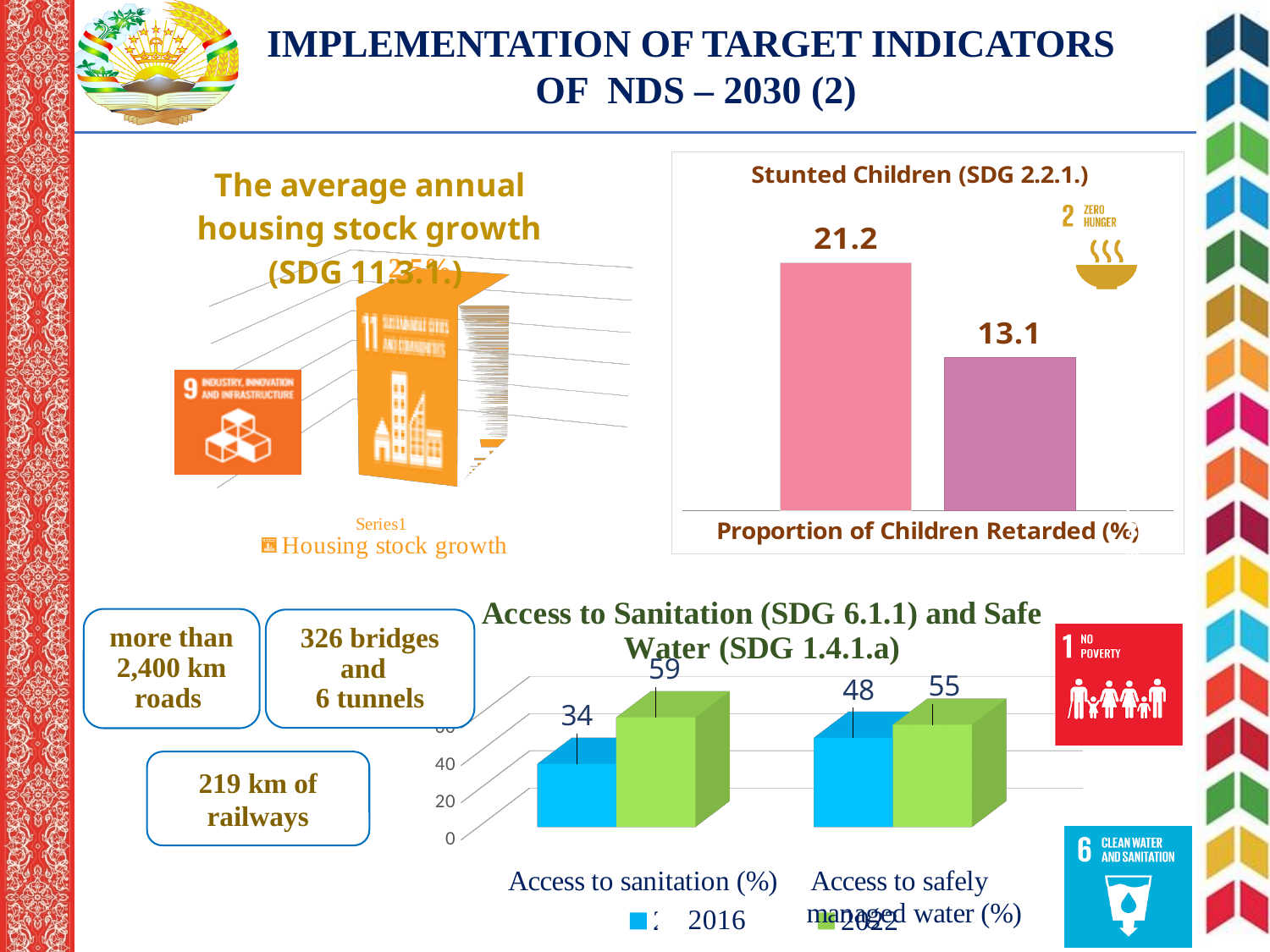
How many series does the legend of the 'Access to Sanitation (SDG 6.1.1) and Safe Water (SDG 1.4.1.a)' chart list? 2 In the 'Access to Sanitation (SDG 6.1.1) and Safe Water (SDG 1.4.1.a)' chart, what is the 2022 value for Access to sanitation (%)? 59 In the 'Access to Sanitation (SDG 6.1.1) and Safe Water (SDG 1.4.1.a)' chart, what is the 2022 value for Access to safely managed water (%)? 55 In the 'Stunted Children (SDG 2.2.1.)' chart, what is the highest value shown? 21.2 What kind of chart is the 'Access to Sanitation (SDG 6.1.1) and Safe Water (SDG 1.4.1.a)' chart? Bar chart In the 'Stunted Children (SDG 2.2.1.)' chart, what is the lowest value shown? 13.1 In the 'Access to Sanitation (SDG 6.1.1) and Safe Water (SDG 1.4.1.a)' chart, by how much did Access to sanitation (%) increase from 2016 to 2022? 25 In the 'Access to Sanitation (SDG 6.1.1) and Safe Water (SDG 1.4.1.a)' chart, what is the 2016 value for Access to safely managed water (%)? 48 In the 'Stunted Children (SDG 2.2.1.)' chart, what is the difference between the two bars? 8.1 In the 'Access to Sanitation (SDG 6.1.1) and Safe Water (SDG 1.4.1.a)' chart, what is the 2016 value for Access to sanitation (%)? 34 How many bars are plotted in the 'Stunted Children (SDG 2.2.1.)' chart? 2 In the 'Access to Sanitation (SDG 6.1.1) and Safe Water (SDG 1.4.1.a)' chart, which is larger in 2016: Access to sanitation (%) or Access to safely managed water (%)? Access to safely managed water (%)